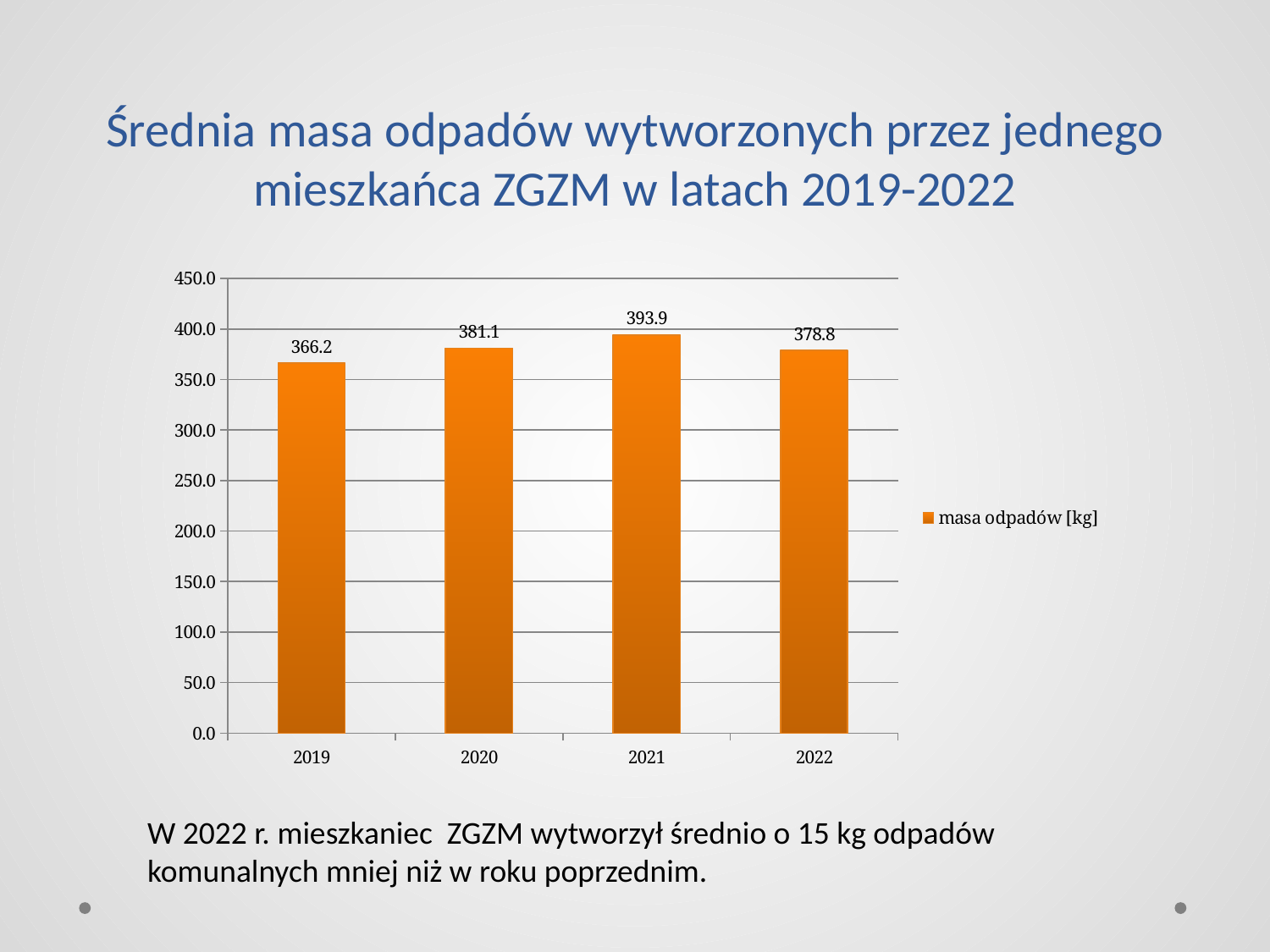
What is the value for 2019? 366.2 What is the difference between the values for 2020 and 2019? 14.9 What series name does the legend show? masa odpadów [kg] What is the difference between the values for 2021 and 2022? 15.1 Is the value for 2021 greater or less than 350.0? greater How many years are shown on the x axis? 4 Which is larger, the value for 2020 or the value for 2022? 2020 What kind of chart is shown on the slide? bar chart What is the value for 2021? 393.9 Which year has the highest value? 2021 What is the value for 2022? 378.8 Which year has the lowest value? 2019